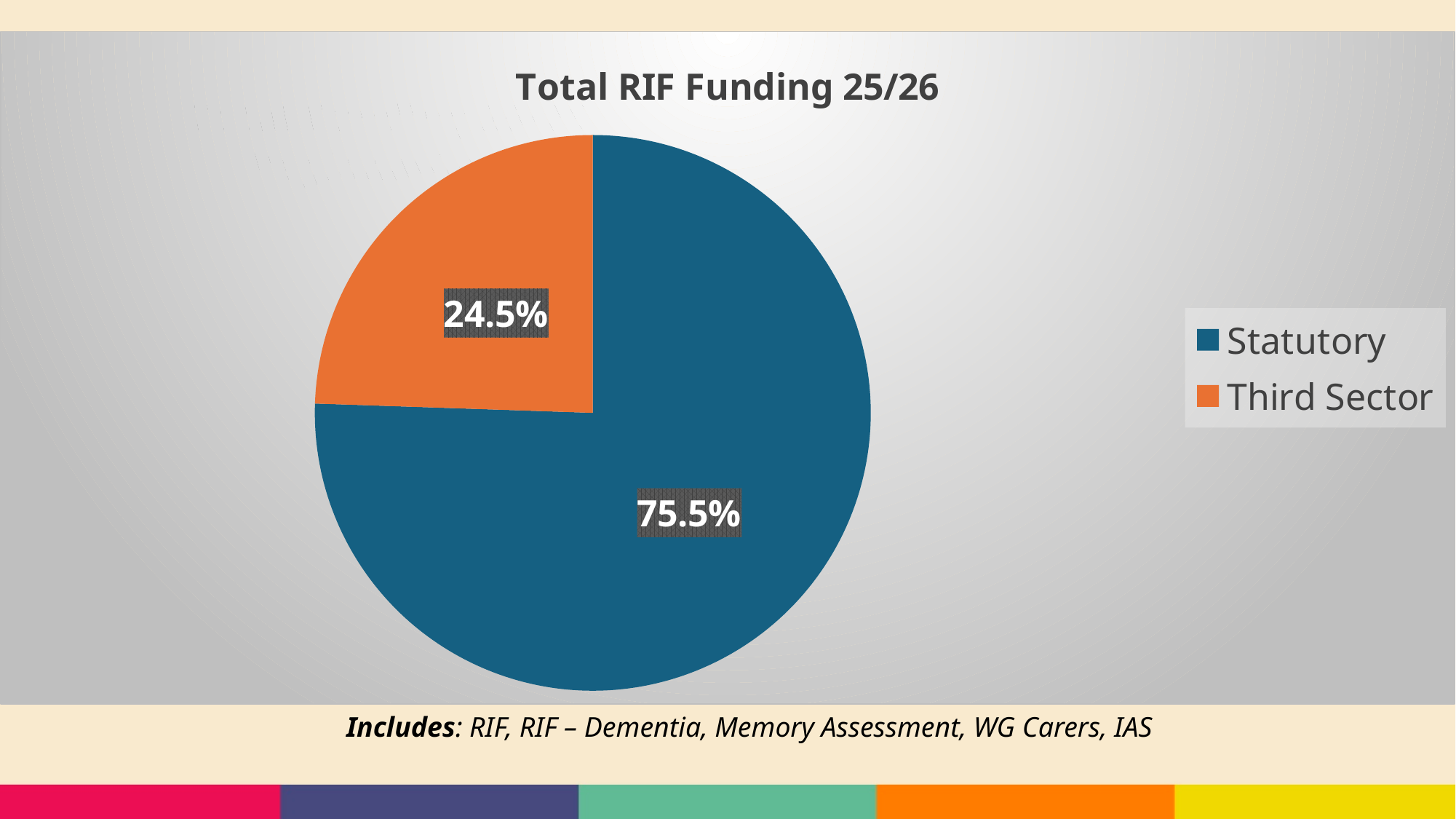
What is the difference in percentage points between the Statutory and Third Sector shares? 51 percentage points Which is larger, the Statutory share or the Third Sector share? Statutory What colour represents Third Sector in the pie chart? Orange What share of Total RIF Funding 25/26 goes to Third Sector? 24.5% Is the Statutory share greater or less than 50%? greater How many categories are shown in the pie chart? 2 What kind of chart is shown on the slide? Pie chart Which category has the largest share of Total RIF Funding 25/26? Statutory How many entries does the legend list? 2 Which category has the smallest share of Total RIF Funding 25/26? Third Sector What is the title of the chart? Total RIF Funding 25/26 What share of Total RIF Funding 25/26 goes to Statutory? 75.5%